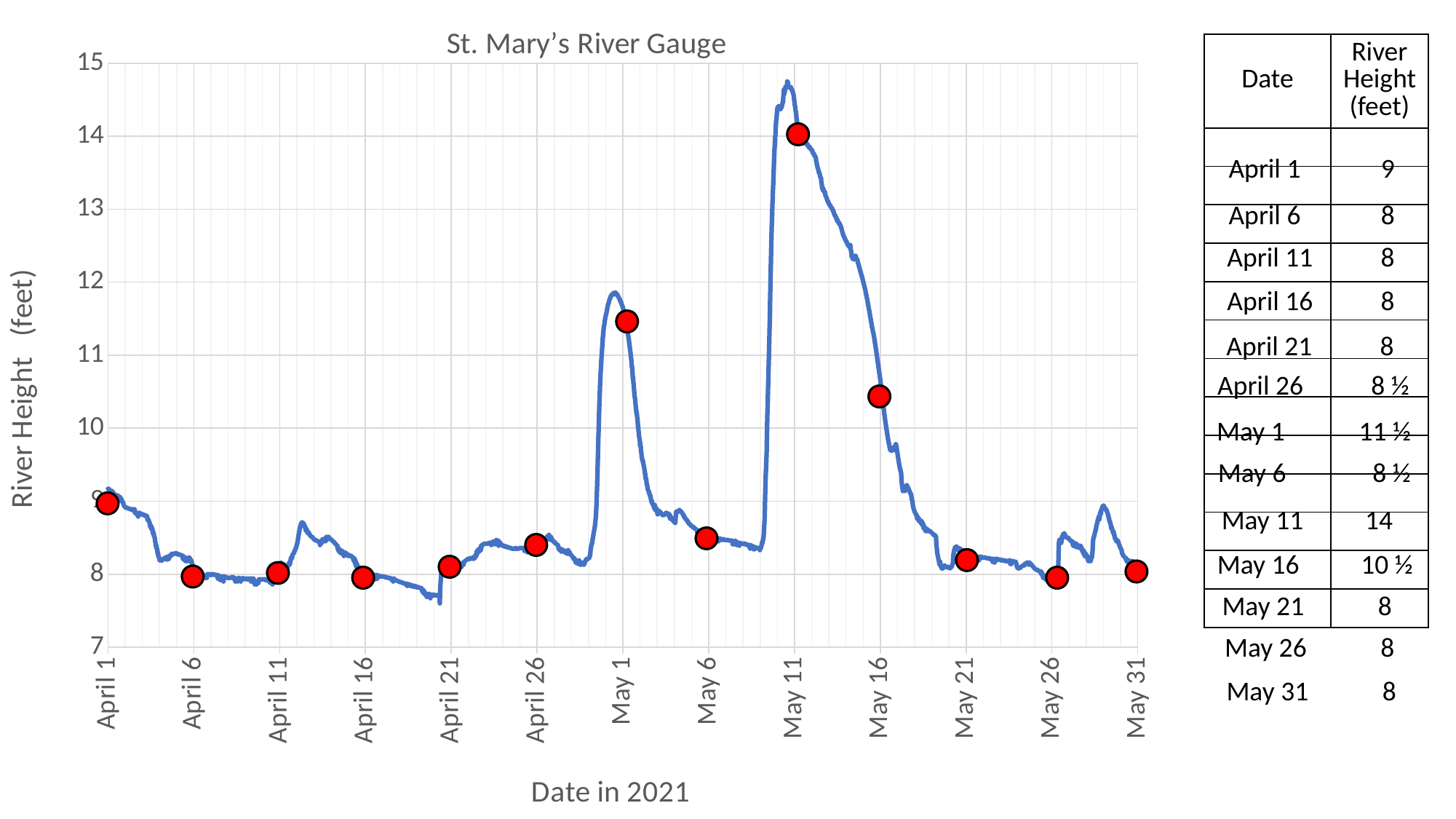
How many red marked points are plotted on the chart? 13 On which date is the river height highest? May 11 Is the river height on May 11 greater or less than 13? greater What is the title of the chart? St. Mary's River Gauge Which date has a greater river height, May 1 or May 16? May 1 What is the river height on May 16? 10 ½ What is the river height on May 11 according to the table? 14 What kind of chart is shown on the slide? line chart Does the river height rise or fall between May 11 and May 21? fall What is the river height on April 26? 8 ½ What is the difference in river height between May 11 and May 1? 2 ½ What is the label of the x axis? Date in 2021